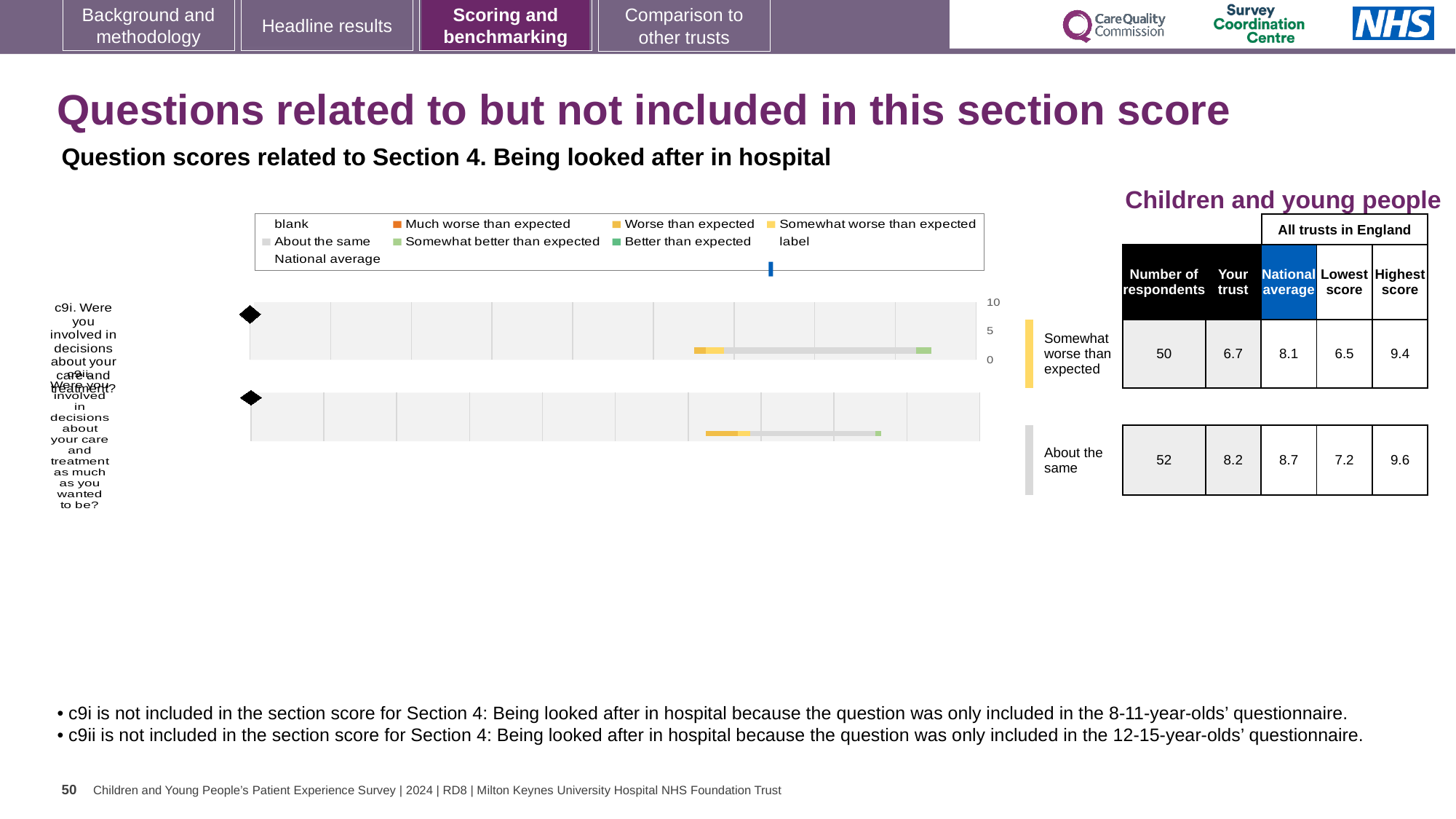
What is the national average score for c9ii in the table beside the chart? 8.7 What is the highest score across all trusts in England for c9ii? 9.6 What is the lowest score across all trusts in England for c9i? 6.5 How many respondents are listed for c9i? 50 What is the difference between the national average and the 'Your trust' score for c9i? 1.4 Is the 'Your trust' score for c9ii greater or less than 5 on the chart's axis? greater Which benchmark category is c9i rated as, according to the label beside the chart? Somewhat worse than expected What is the 'Your trust' score for c9i in the table beside the chart? 6.7 What kind of chart is shown on the slide? bar chart What is the highest tick value shown on the chart's axis? 10 How many questions (bars) are plotted in the chart? 2 Which question has the higher 'Your trust' score, c9i or c9ii? c9ii